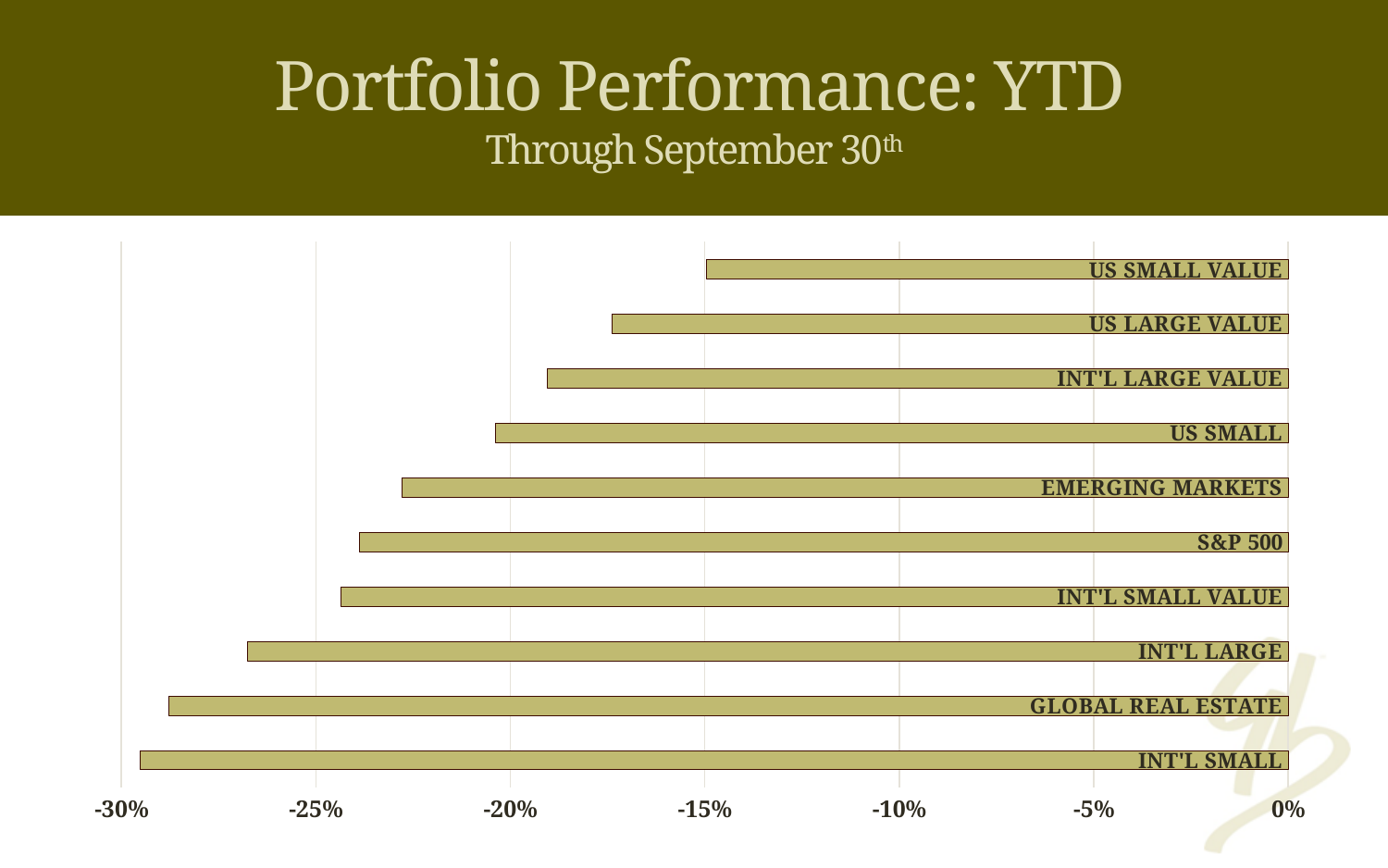
Is the value for Emerging Markets greater or less than -20%? less Is the value for US Small greater or less than -25%? greater Is the value for US Large Value greater or less than -15%? less Which asset class has the lowest YTD return? Int'l Small What type of chart is shown on the slide? bar chart Which asset class has the highest (least negative) YTD return? US Small Value What is the title of the slide containing the chart? Portfolio Performance: YTD Which has the lower YTD return, Global Real Estate or US Large Value? Global Real Estate Which has the higher YTD return, US Small or Int'l Large? US Small How many asset classes are plotted in the chart? 10